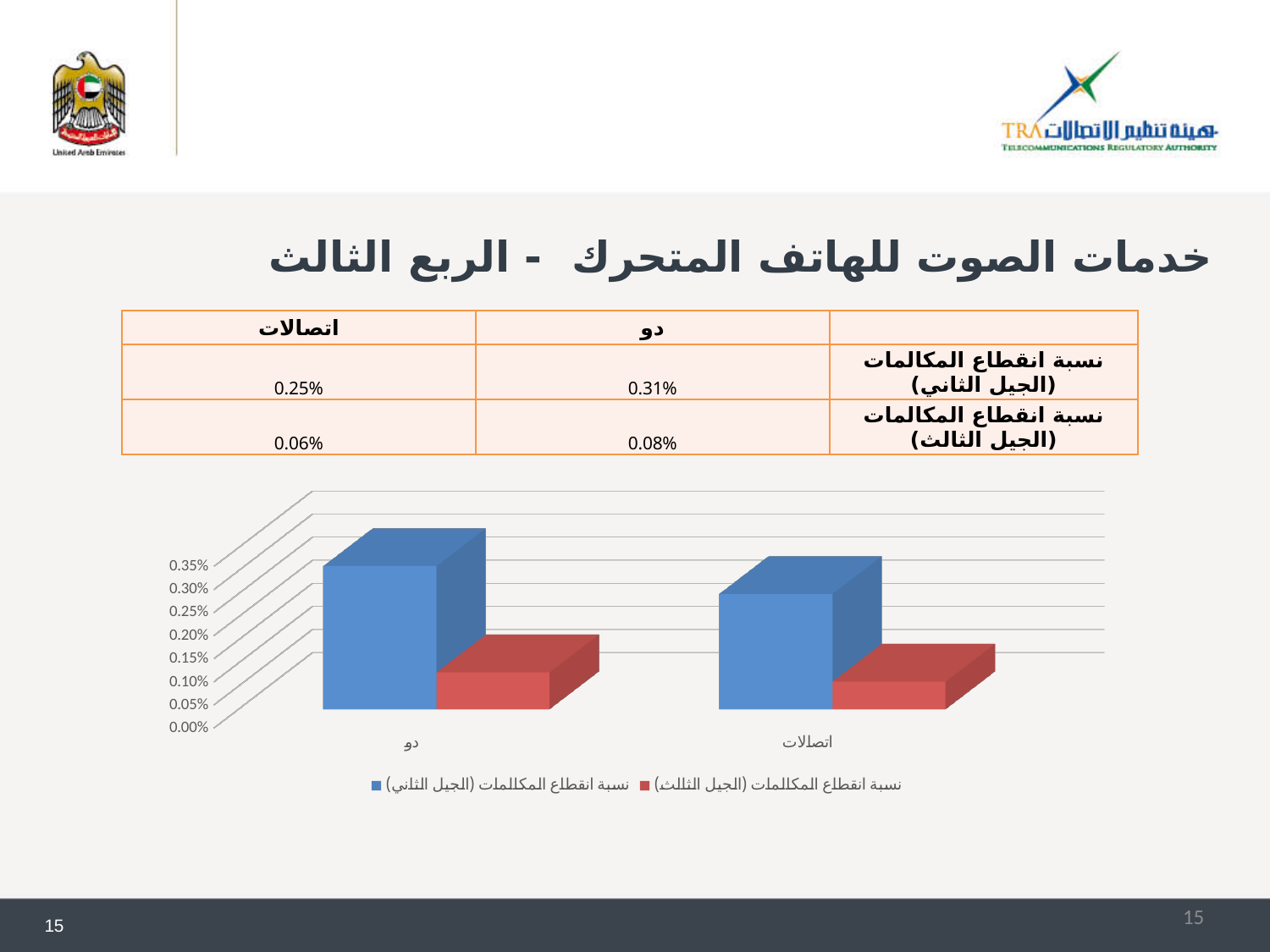
What is the difference between the نسبة انقطاع المكالمات (الجيل الثاني) values for دو and اتصالات? 0.06% Is the value of نسبة انقطاع المكالمات (الجيل الثاني) for دو greater or less than 0.20%? greater Which colour represents نسبة انقطاع المكالمات (الجيل الثالث) in the chart? red What type of chart is shown on the slide? bar chart According to the slide, what is the value of نسبة انقطاع المكالمات (الجيل الثاني) for اتصالات? 0.25% Which category has the lowest value for نسبة انقطاع المكالمات (الجيل الثالث)? اتصالات Which category has the higher value for نسبة انقطاع المكالمات (الجيل الثاني), دو or اتصالات? دو How many series does the chart legend list? 2 According to the slide, what is the value of نسبة انقطاع المكالمات (الجيل الثالث) for اتصالات? 0.06% Is the value of نسبة انقطاع المكالمات (الجيل الثالث) for دو greater or less than 0.15%? less According to the slide, what is the value of نسبة انقطاع المكالمات (الجيل الثاني) for دو? 0.31% How many categories are shown on the x axis of the chart? 2